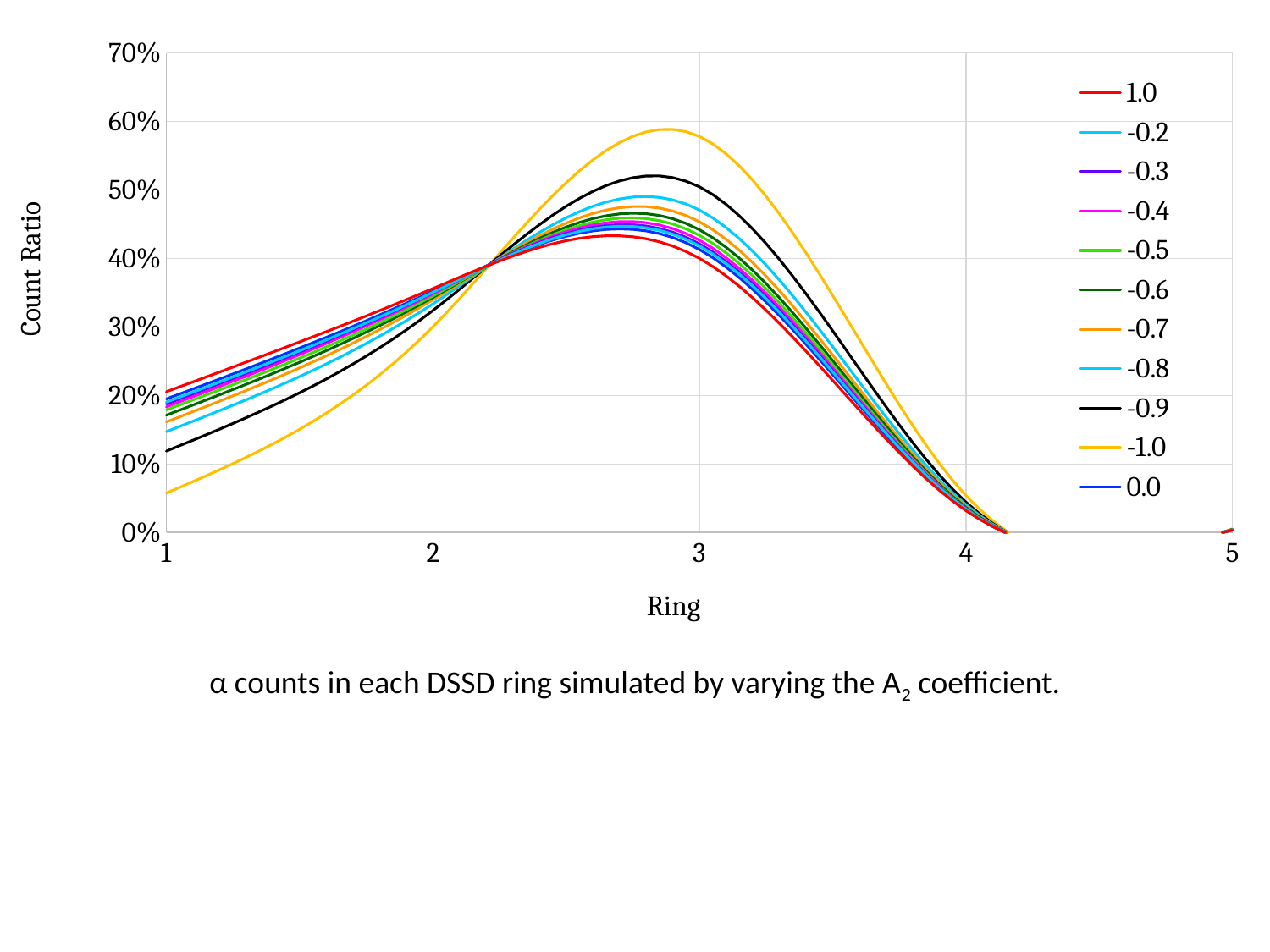
Is the peak value of the 1.0 series greater or less than 50%? less Is the value of the -0.9 series at Ring 1 greater or less than 20%? less Is the value of the -1.0 series at Ring 1 greater or less than 10%? less How many series does the legend list? 11 Between Ring 3 and Ring 4, do the values of the series rise or fall? fall Which series has the lowest value at Ring 1? -1.0 What kind of chart is shown on the slide? line chart What is the label of the x axis? Ring Which series reaches the highest peak value? -1.0 What is the label of the y axis? Count Ratio At Ring 3, which series has the larger value, -1.0 or 1.0? -1.0